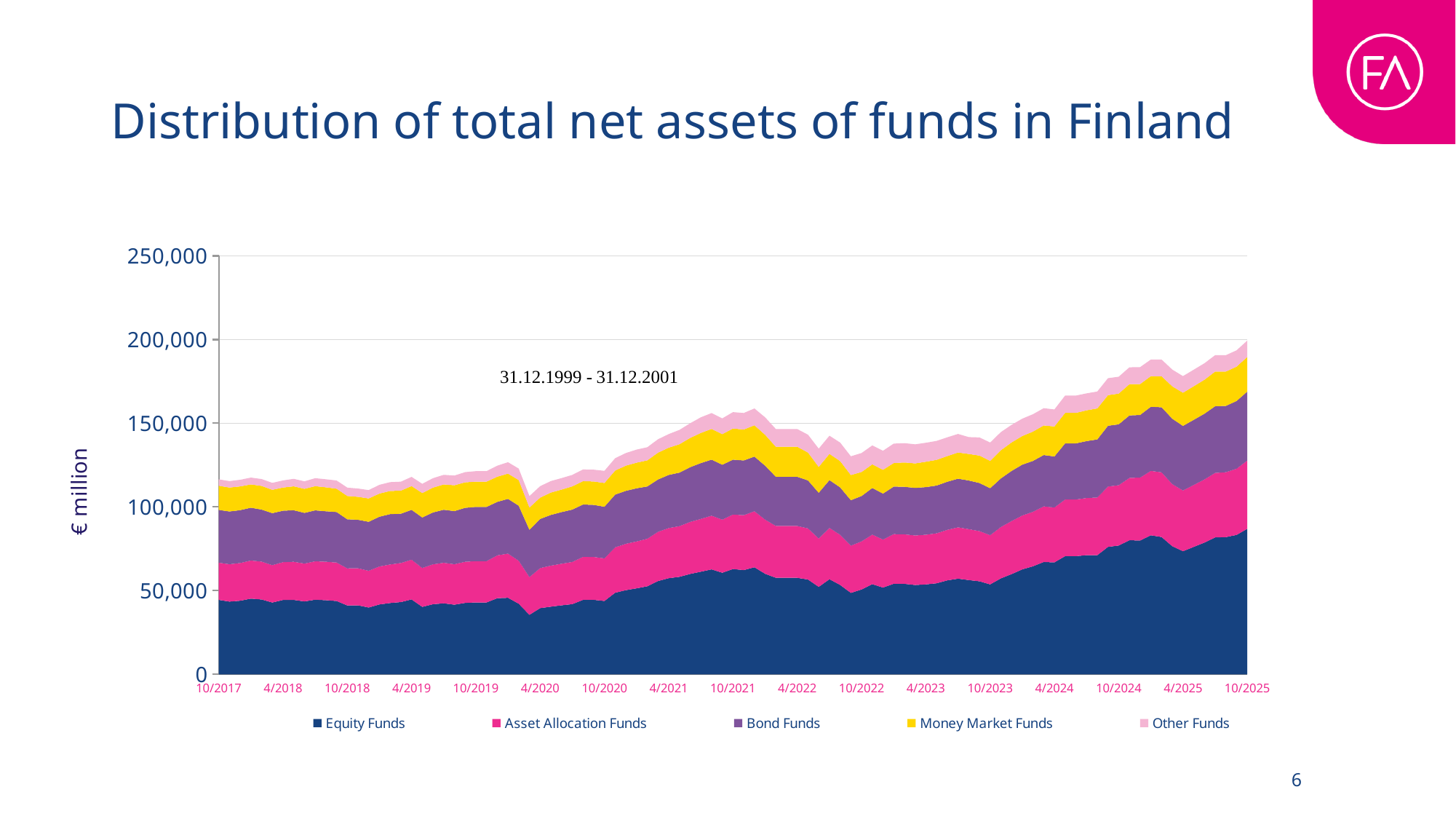
Which fund type has the smallest net assets at 10/2025? Other Funds How many series does the legend list? 5 Is the total net assets value at 10/2025 greater or less than 150,000? greater What is the label on the y axis? € million Is the Equity Funds value at 10/2025 greater or less than 50,000? greater Is the total net assets value at 10/2022 greater or less than 100,000? greater Which fund type has the largest net assets at 10/2025? Equity Funds Do total net assets overall rise or fall from 10/2017 to 10/2025? Rise How many date labels are shown on the x axis? 17 What kind of chart is shown on the slide? Stacked area chart